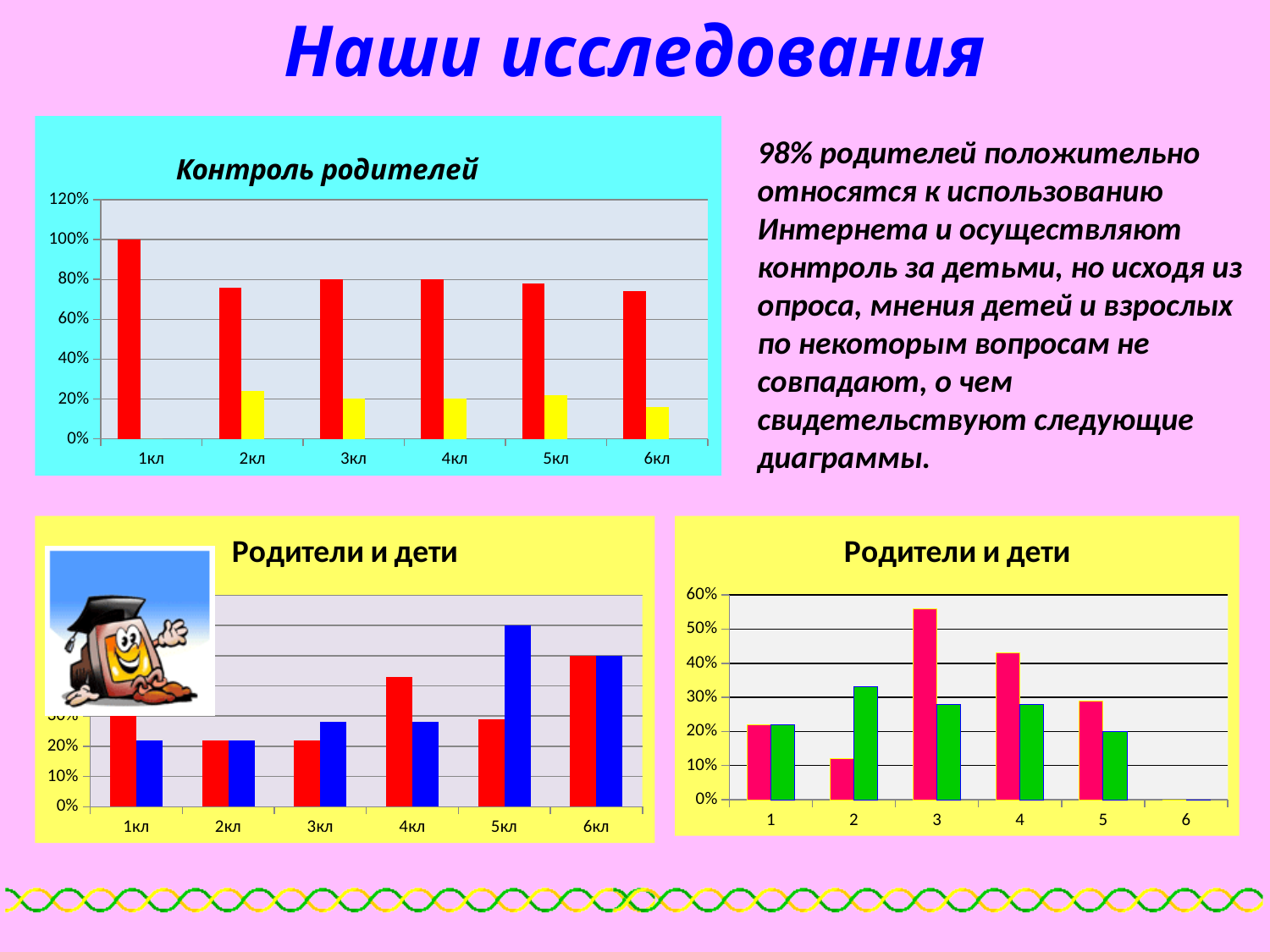
In the bottom-left chart "Родители и дети", which category has the highest blue bar? 5кл How many categories are shown on the x axis of the top-left chart "Контроль родителей"? 6 What kind of chart is the top-left chart titled "Контроль родителей"? bar chart In the top-left chart "Контроль родителей", is the yellow bar for 2кл greater or less than 40%? less In the bottom-right chart "Родители и дети", is the pink bar for category 3 greater or less than 50%? greater In the top-left chart "Контроль родителей", is the red bar for 2кл greater or less than 60%? greater In the bottom-right chart "Родители и дети", which bar is larger for category 2, the pink one or the green one? green In the bottom-right chart "Родители и дети", which category has the highest pink bar? 3 In the top-left chart "Контроль родителей", which category has the highest red bar? 1кл In the top-left chart "Контроль родителей", what is the value of the red bar for 1кл? 100% In the bottom-left chart "Родители и дети", which bar is larger for 5кл, the red one or the blue one? blue